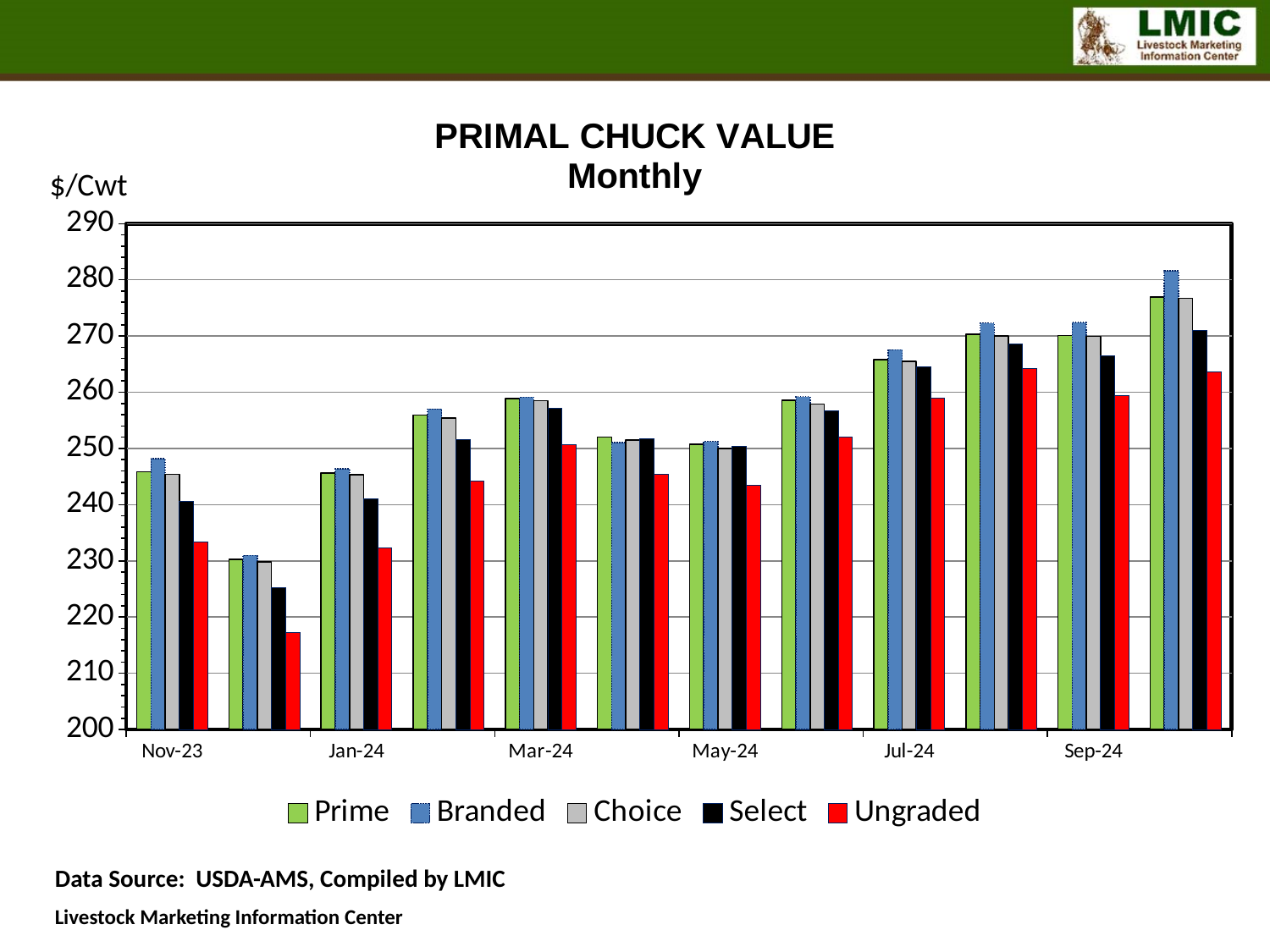
What unit is shown on the y axis of the chart? $/Cwt What kind of chart is shown on the slide? Bar chart Is the Prime value for Nov-23 greater or less than 250? less How many series does the legend list? 5 Which series has the lowest value in Jul-24? Ungraded Is the Ungraded value for Nov-23 greater or less than 230? greater Which is larger, the Prime value for Mar-24 or the Prime value for Jul-24? Jul-24 Is the Branded value for Sep-24 greater or less than 260? greater Which series has the highest value in Sep-24? Branded Do the Ungraded values rise or fall from May-24 to Sep-24? Rise How many groups of bars are plotted along the x axis? 12